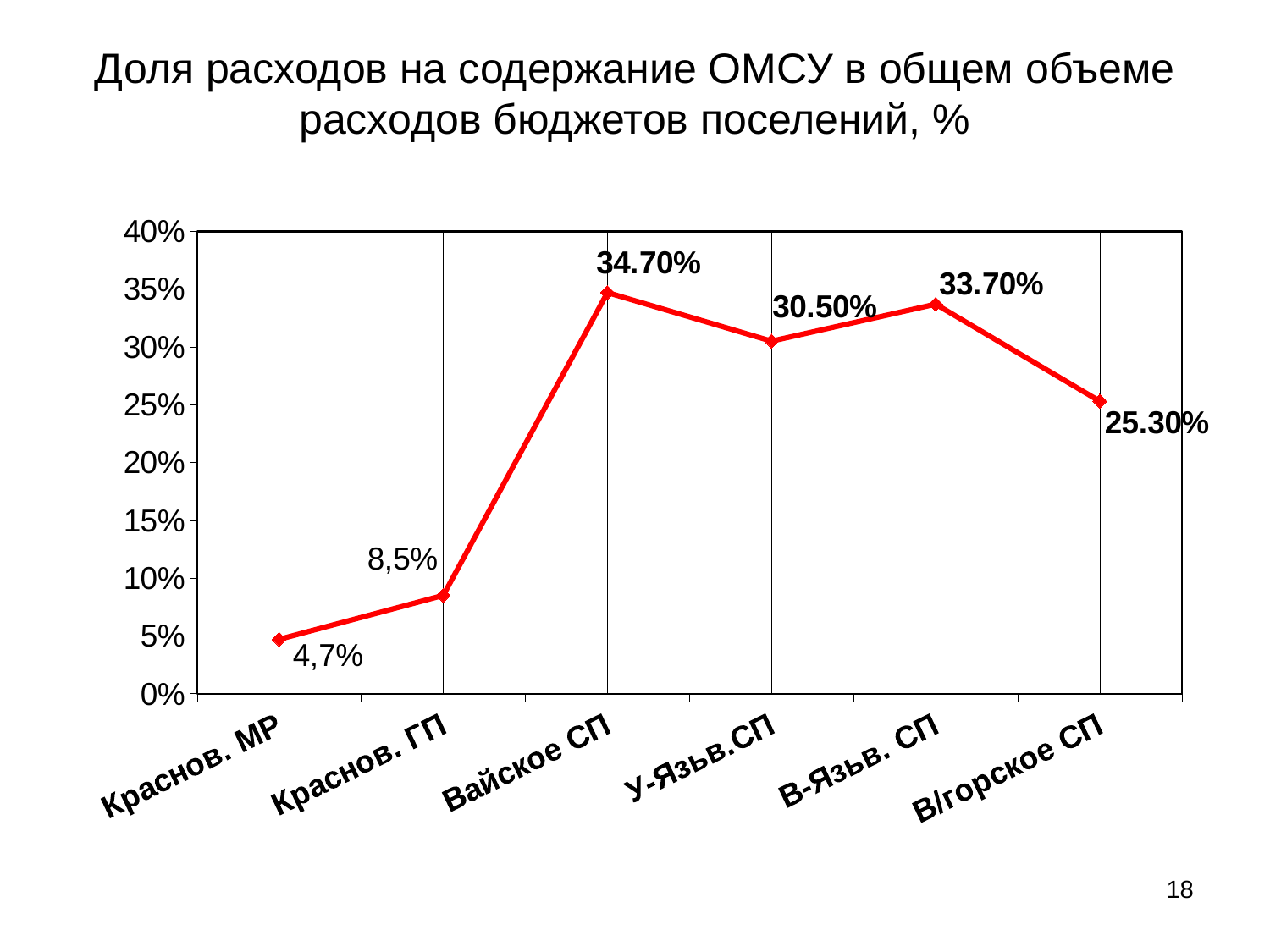
Which category has the lowest value? Краснов. МР What is the value for Краснов. ГП? 8,5% What is the difference between the values for Вайское СП and У-Язьв.СП? 4.20% What is the difference between the values for В-Язьв. СП and В/горское СП? 8.40% What is the value for Вайское СП? 34.70% What colour is the plotted line? red What is the value for Краснов. МР? 4,7% Which is larger, the value for У-Язьв.СП or the value for В/горское СП? У-Язьв.СП What is the value for В/горское СП? 25.30% What kind of chart is shown on the slide? line chart Which category has the highest value? Вайское СП How many categories are plotted on the x axis? 6